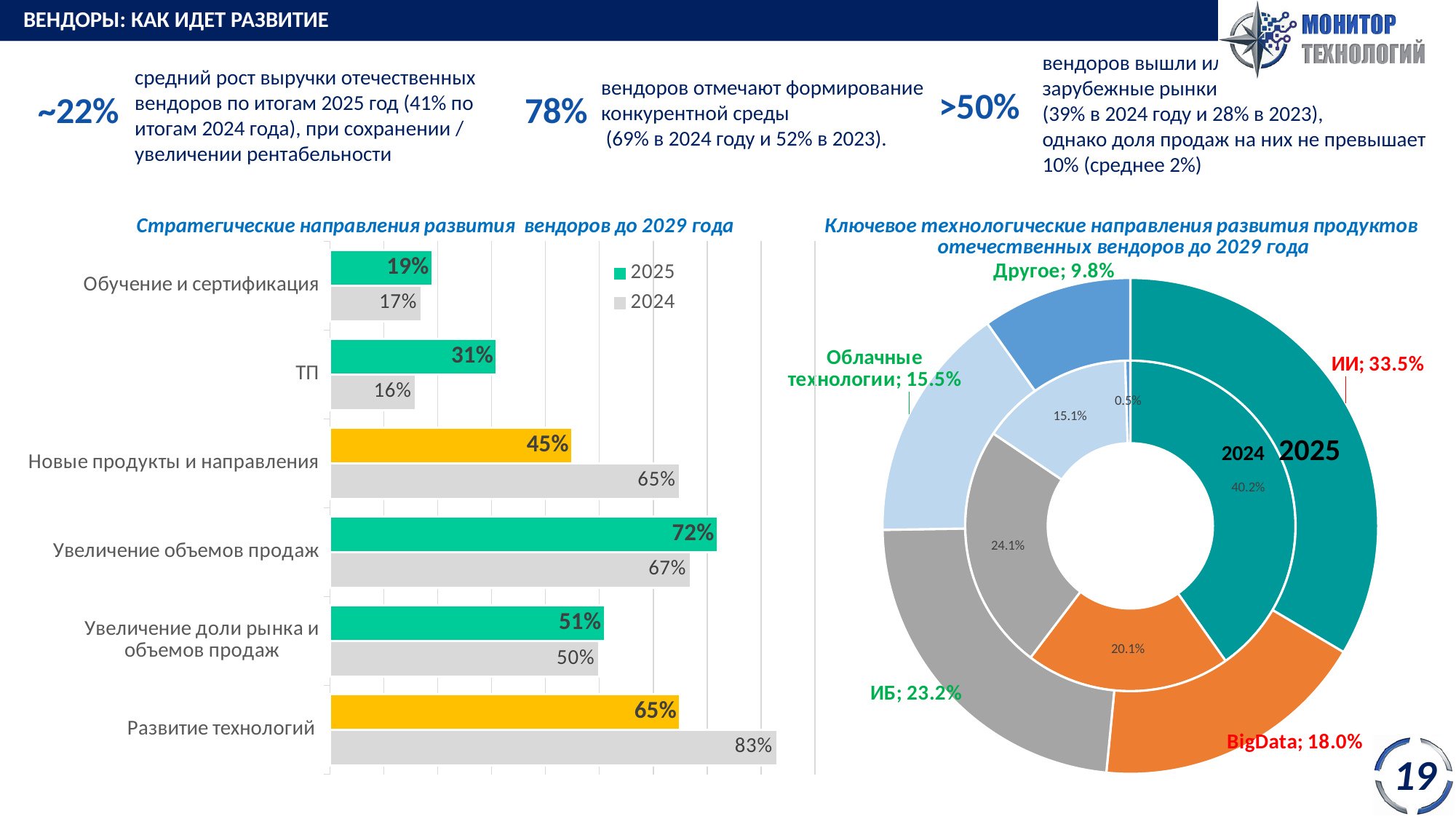
On the bar chart 'Стратегические направления развития вендоров до 2029 года', what is the 2024 value for 'Развитие технологий'? 83% How many series does the legend of the bar chart 'Стратегические направления развития вендоров до 2029 года' list? 2 How many categories are shown on the bar chart 'Стратегические направления развития вендоров до 2029 года'? 6 On the bar chart 'Стратегические направления развития вендоров до 2029 года', which category has the lowest 2024 value? ТП On the doughnut chart on the right, what is the 2025 share for 'ИИ'? 33.5% On the bar chart 'Стратегические направления развития вендоров до 2029 года', what is the 2025 value for 'ТП'? 31% On the bar chart 'Стратегические направления развития вендоров до 2029 года', is the 2025 value for 'Развитие технологий' larger or smaller than its 2024 value? smaller What type of chart is the chart on the right, 'Ключевое технологические направления развития продуктов отечественных вендоров до 2029 года'? doughnut chart On the bar chart 'Стратегические направления развития вендоров до 2029 года', what is the difference between the 2024 and 2025 values for 'Новые продукты и направления'? 20% On the bar chart 'Стратегические направления развития вендоров до 2029 года', what is the 2025 value for 'Увеличение объемов продаж'? 72% On the bar chart 'Стратегические направления развития вендоров до 2029 года', which category has the highest 2025 value? Увеличение объемов продаж On the doughnut chart on the right, what is the 2025 share for 'Облачные технологии'? 15.5%